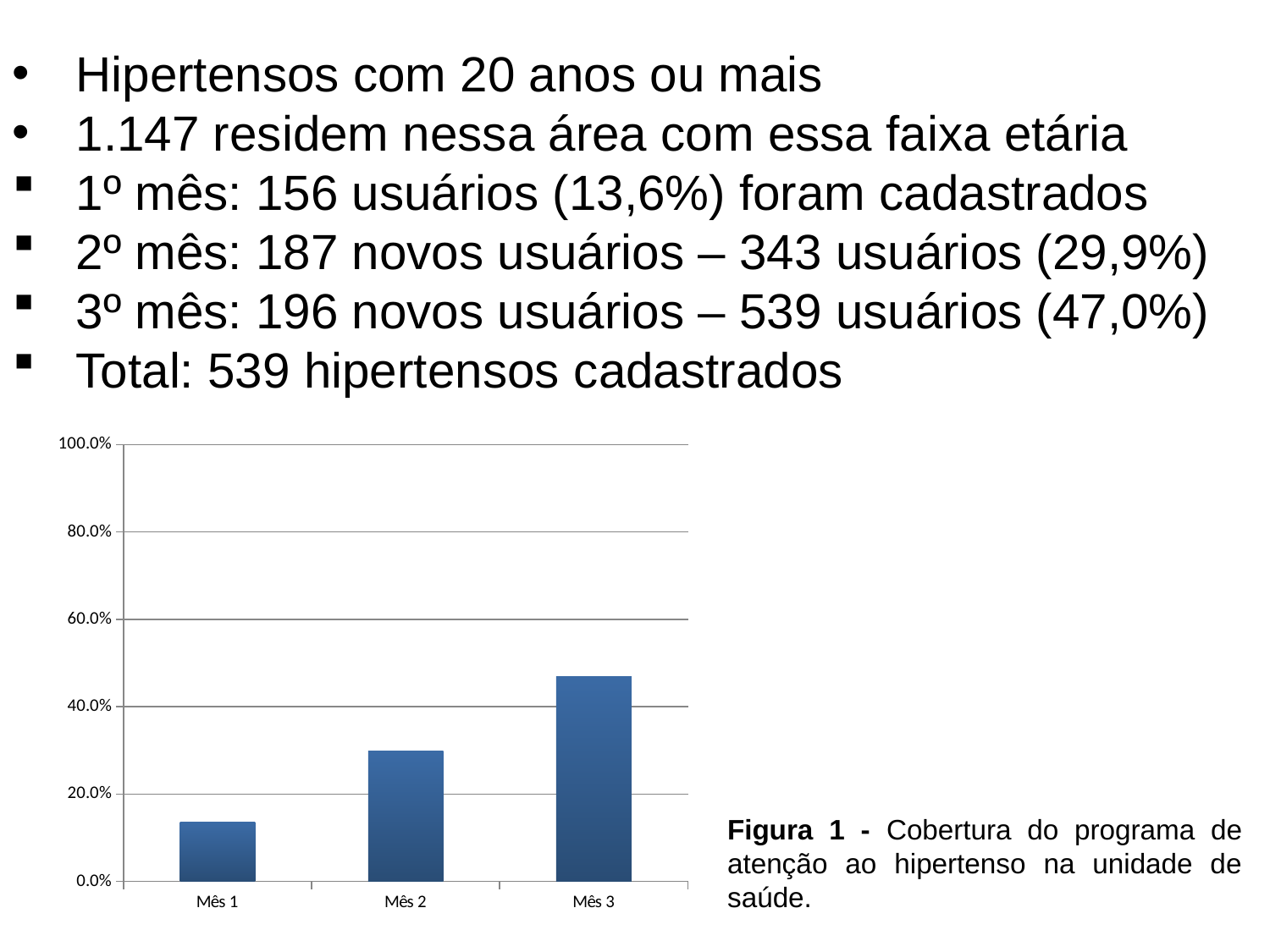
Is the value for Mês 2 greater or less than 40.0%? less Is the value for Mês 3 greater or less than 40.0%? greater Is the value for Mês 1 greater or less than 20.0%? less Which month has the lowest bar in the chart? Mês 1 What is the maximum value shown on the chart's vertical axis? 100.0% Which month has the highest bar in the chart? Mês 3 Which is larger, the value for Mês 1 or the value for Mês 2? Mês 2 Do the values rise or fall from Mês 1 to Mês 3? rise What kind of chart is shown in Figura 1? bar chart How many bars (categories) does the chart show? 3